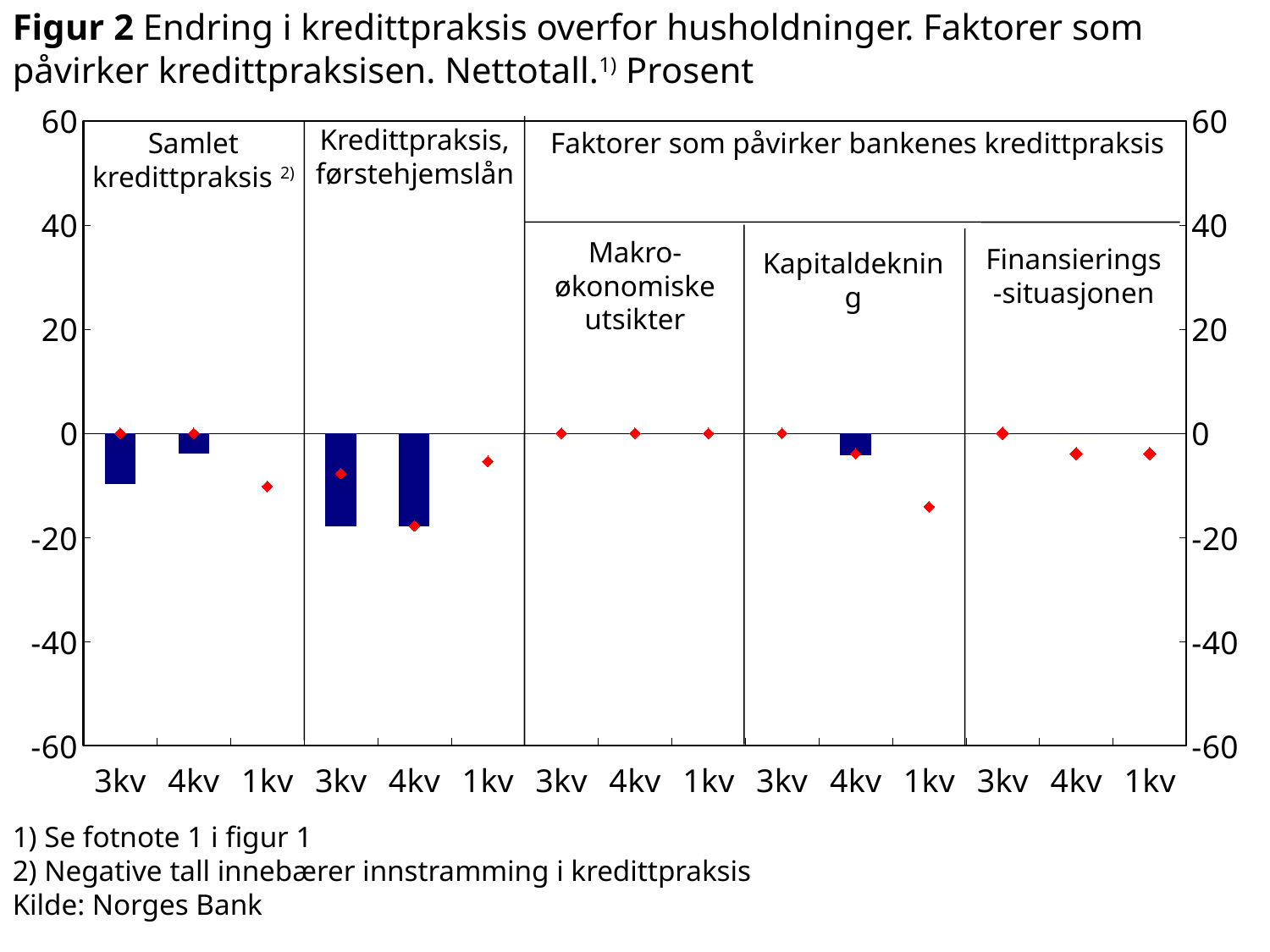
Is the bar for 3kv in the 'Kredittpraksis, førstehjemslån' panel greater or less than -10? less Which 3kv bar is lower, the one in 'Samlet kredittpraksis' or the one in 'Kredittpraksis, førstehjemslån'? Kredittpraksis, førstehjemslån What is the maximum value shown on the y axis? 60 Is the red marker for 1kv in the 'Kapitaldekning' panel greater or less than -10? less In the 'Samlet kredittpraksis' panel, which bar is lower, 3kv or 4kv? 3kv Is the bar for 4kv in the 'Samlet kredittpraksis' panel greater or less than -10? greater What source is cited for the chart? Norges Bank How many panels (groups) is the chart divided into? 5 How many quarter labels are shown along the x axis? 15 What kind of chart is shown on the slide? bar chart